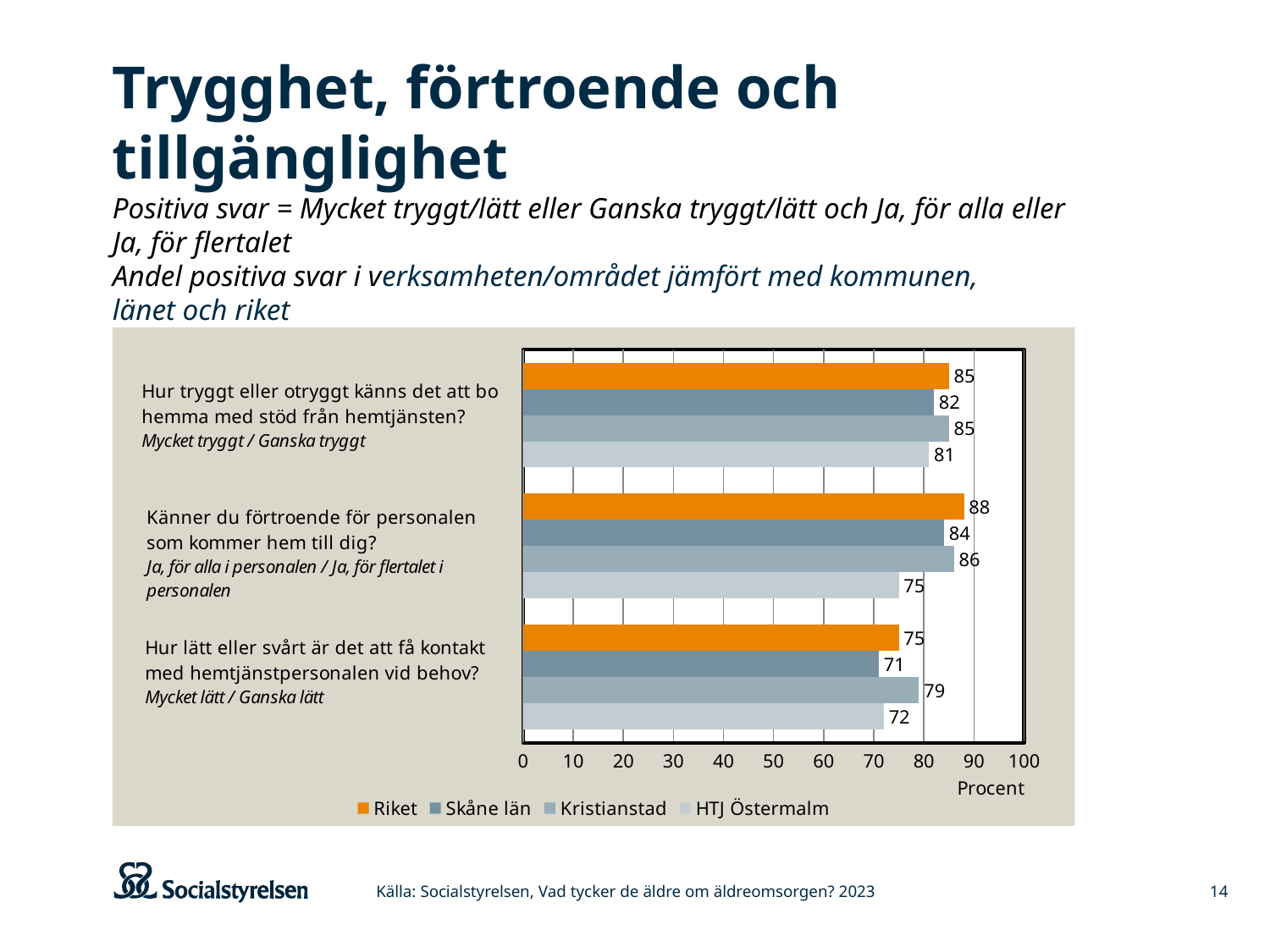
What is the value for HTJ Östermalm on the question 'Känner du förtroende för personalen som kommer hem till dig?' 75 Which colour represents Riket in the chart? Orange What is the difference between Riket and HTJ Östermalm on the question 'Känner du förtroende för personalen som kommer hem till dig?' 13 Which series has the highest value on the question 'Hur lätt eller svårt är det att få kontakt med hemtjänstpersonalen vid behov?' Kristianstad How many question categories are shown on the chart? 3 Which is larger on the question 'Hur lätt eller svårt är det att få kontakt med hemtjänstpersonalen vid behov?': Skåne län or HTJ Östermalm? HTJ Östermalm What is the value for Riket on the question 'Hur lätt eller svårt är det att få kontakt med hemtjänstpersonalen vid behov?' 75 How many series does the legend list? 4 Which series has the lowest value on the question 'Känner du förtroende för personalen som kommer hem till dig?' HTJ Östermalm What is the value for Skåne län on the question 'Hur tryggt eller otryggt känns det att bo hemma med stöd från hemtjänsten?' 82 What is the label on the horizontal axis of the chart? Procent What kind of chart is shown on the slide? Bar chart